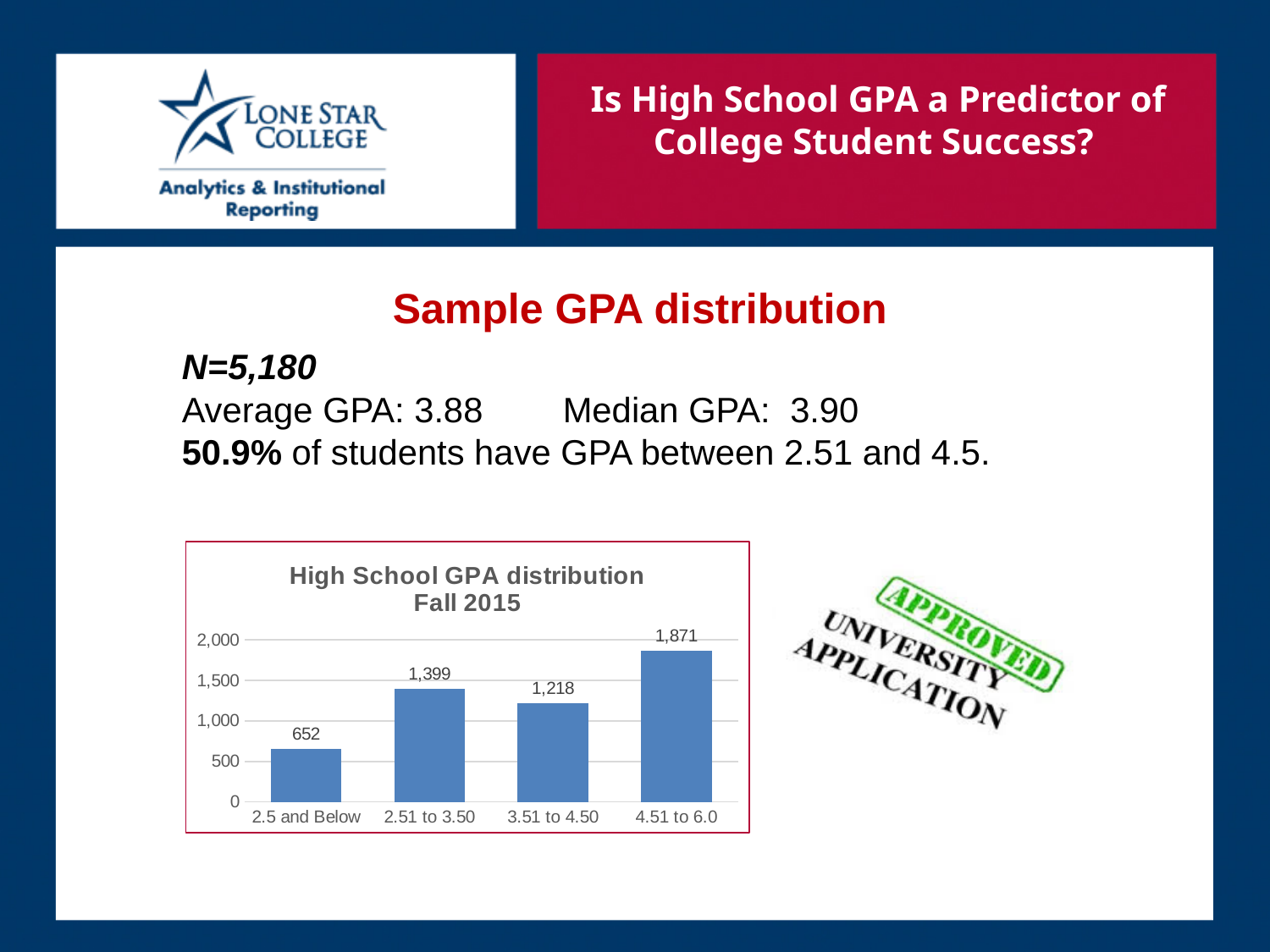
What is the difference between the values for 2.51 to 3.50 and 3.51 to 4.50? 181 What is the value for the 3.51 to 4.50 category? 1,218 What kind of chart is shown on the slide? Bar chart Which is larger, the value for 2.51 to 3.50 or the value for 3.51 to 4.50? 2.51 to 3.50 Which GPA category has the lowest value? 2.5 and Below What is the title of the chart? High School GPA distribution Fall 2015 What is the value for the 2.5 and Below category? 652 What is the value for the 4.51 to 6.0 category? 1,871 How many GPA categories are shown in the chart? 4 What is the difference between the values for 4.51 to 6.0 and 2.5 and Below? 1,219 What is the value for the 2.51 to 3.50 category? 1,399 Which GPA category has the highest value? 4.51 to 6.0